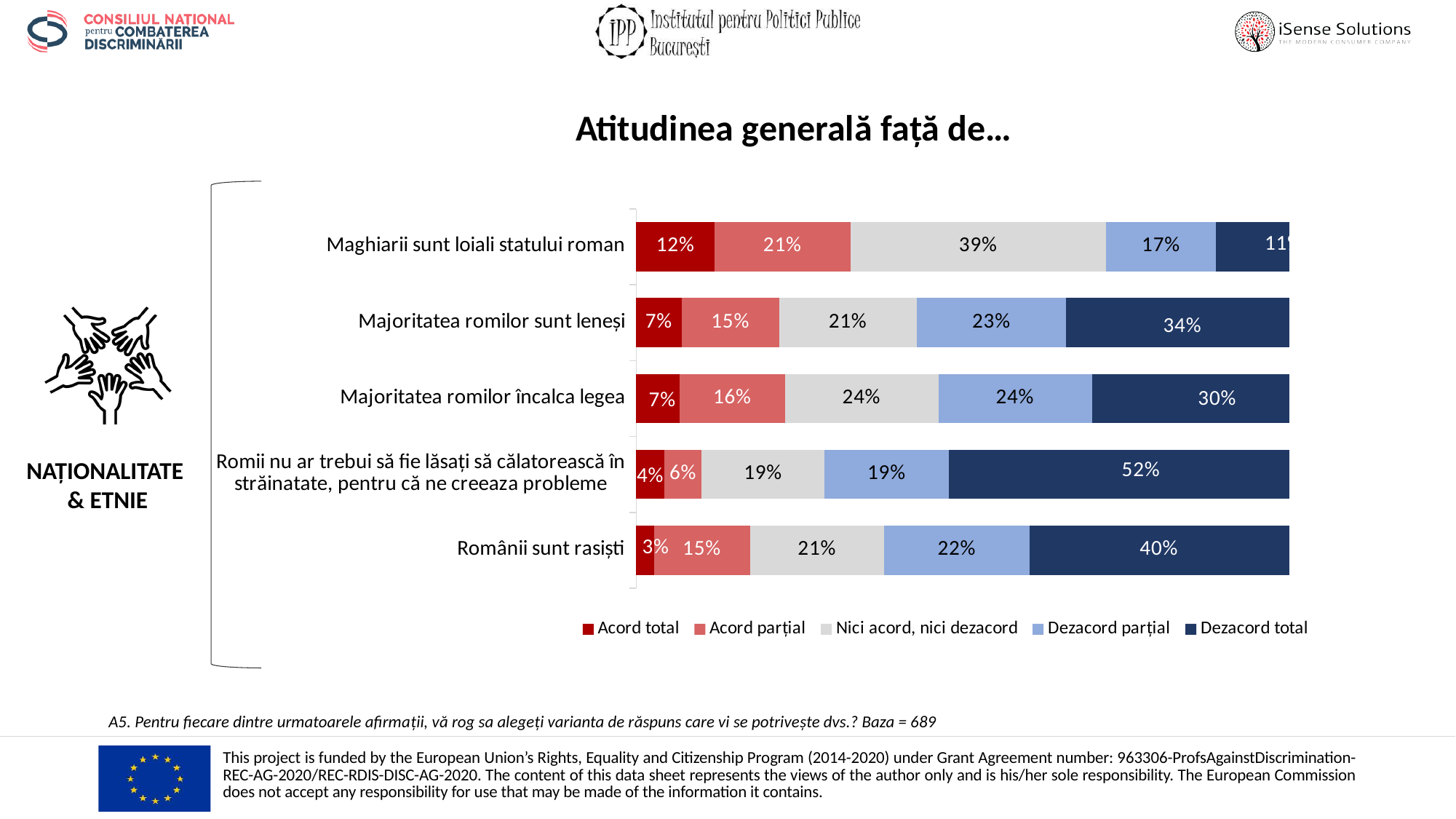
Which is larger: the 'Acord parțial' value for 'Maghiarii sunt loiali statului roman' or for 'Majoritatea romilor încalca legea'? Maghiarii sunt loiali statului roman What kind of chart is shown on the slide? stacked bar chart What is the 'Nici acord, nici dezacord' value for 'Maghiarii sunt loiali statului roman'? 39% What is the 'Dezacord total' value for 'Romii nu ar trebui să fie lăsați să călatorească în străinatate, pentru că ne creeaza probleme'? 52% What is the 'Dezacord parțial' value for 'Majoritatea romilor sunt leneși'? 23% How many series does the legend list? 5 What is the difference between the 'Dezacord total' values for 'Românii sunt rasiști' and 'Majoritatea romilor încalca legea'? 10% Which statement has the lowest 'Acord total' value? Românii sunt rasiști Which statement has the highest 'Dezacord total' value? Romii nu ar trebui să fie lăsați să călatorească în străinatate, pentru că ne creeaza probleme How many statements (categories) are plotted in the chart? 5 What is the title of the chart? Atitudinea generală față de… What is the 'Acord total' value for 'Românii sunt rasiști'? 3%